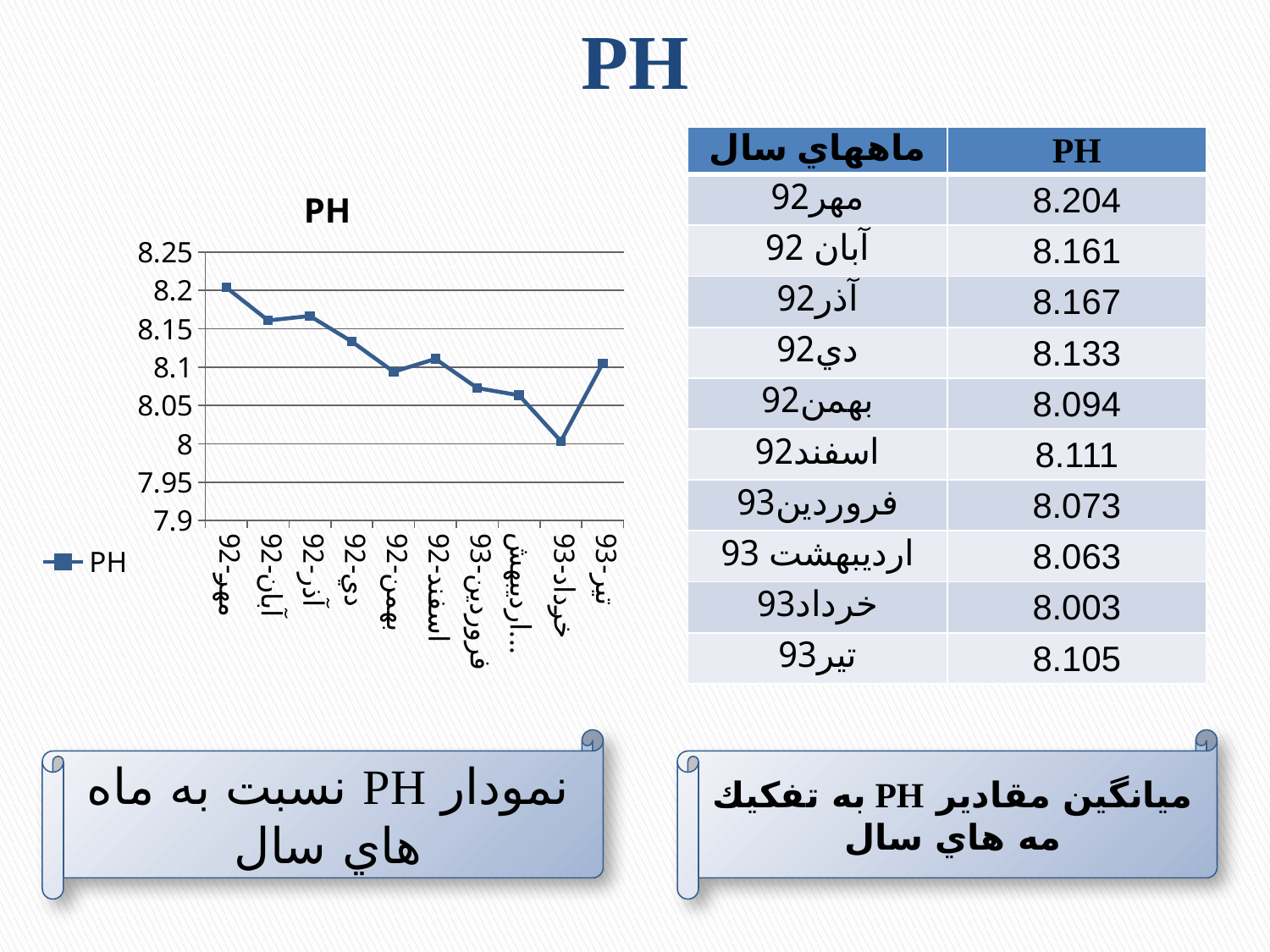
What kind of chart is shown on the slide? line chart Which month has the lowest PH value on the chart? خرداد93 What is the PH value for تير93? 8.105 Which has a higher PH value, مهر92 or آبان 92? مهر92 Is the PH value for دي92 greater or less than 8.1? greater Does the PH value generally rise or fall from مهر92 to خرداد93? fall Which month has the highest PH value on the chart? مهر92 What is the difference between the PH values for مهر92 and خرداد93? 0.201 What is the PH value for مهر92? 8.204 How many series does the legend of the PH chart list? 1 What is the PH value for خرداد93? 8.003 How many months (data points) are plotted on the PH chart? 10